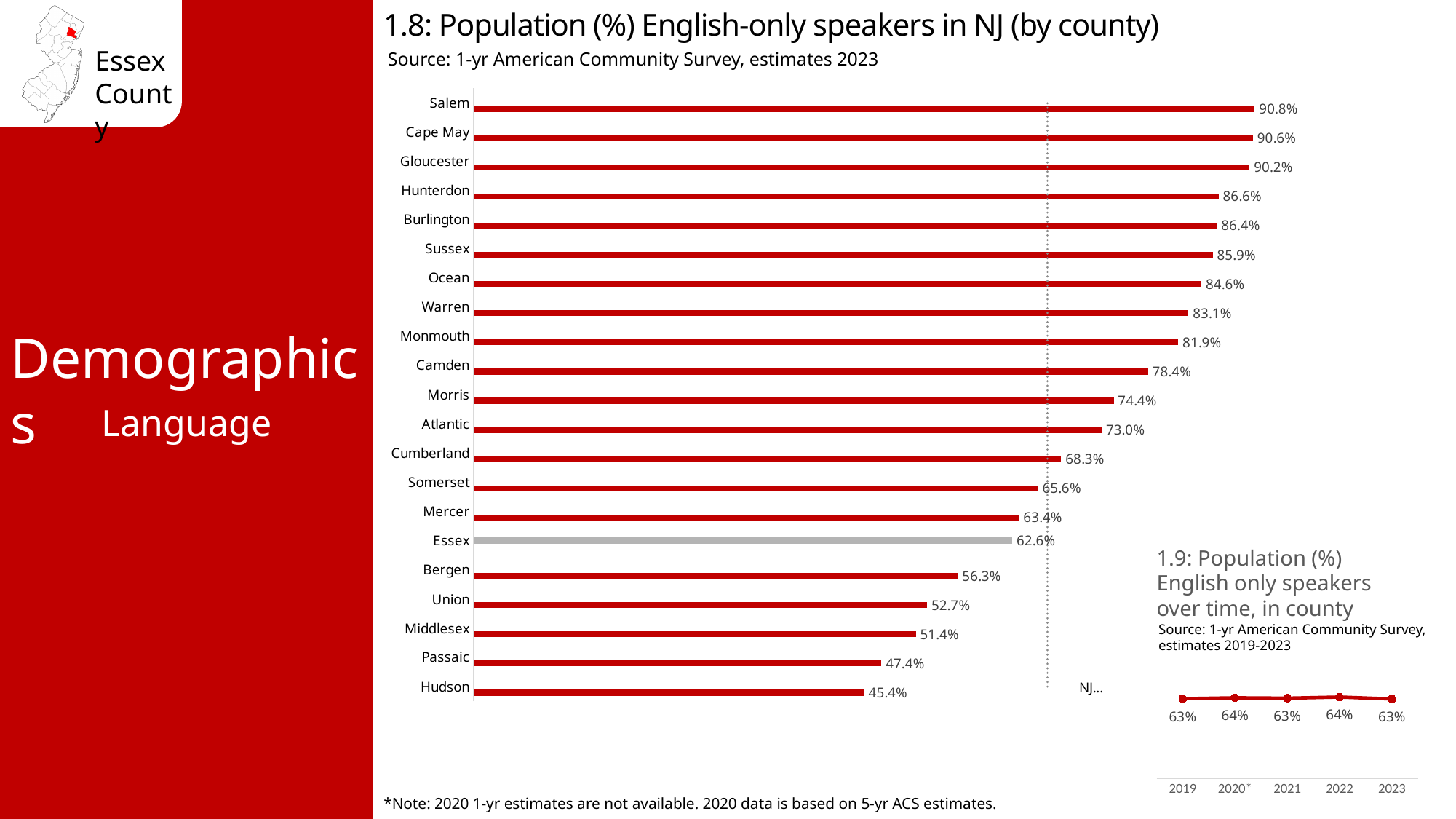
In chart 1.8, what is the difference between the values for Salem and Hudson? 45.4% In chart 1.8, which bar is coloured grey instead of red? Essex In chart 1.8, which county has the highest percentage of English-only speakers? Salem In chart 1.8, which county has the lowest percentage of English-only speakers? Hudson What type of chart is chart 1.8? Bar chart In chart 1.8 (Population (%) English-only speakers in NJ by county), what is the value for Essex? 62.6% In chart 1.8, how many counties are shown? 21 In chart 1.9 (Population (%) English only speakers over time, in county), what is the value for 2022? 64% In chart 1.8, what is the difference between the values for Mercer and Essex? 0.8% In chart 1.8, what is the value for Hudson? 45.4% In chart 1.8, which has a higher value, Bergen or Union? Bergen In chart 1.9, how many years are plotted? 5